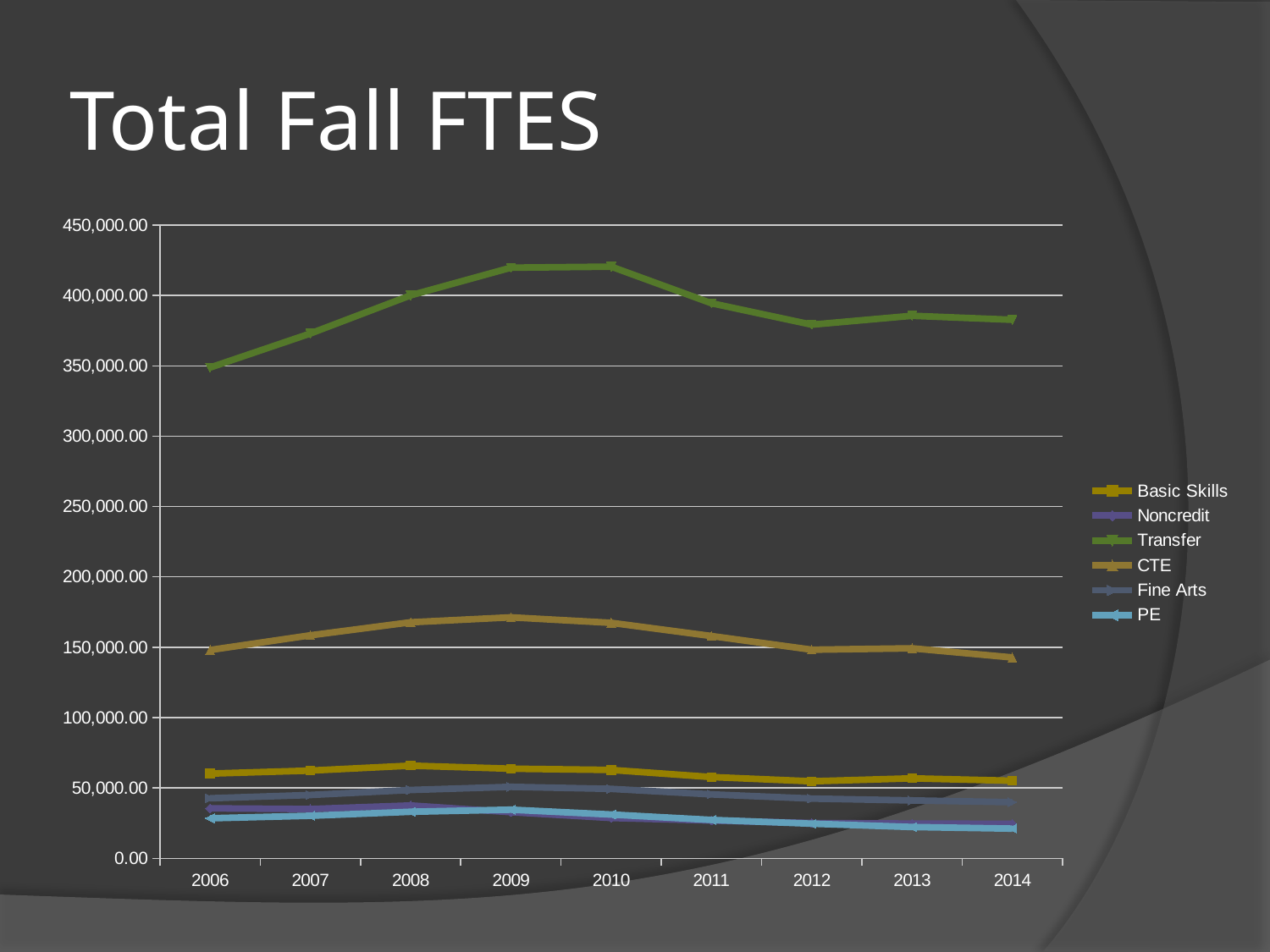
In which year is the value for Transfer lowest? 2006 What kind of chart is shown on the slide? Line chart In 2009, which is larger, the value for Transfer or the value for CTE? Transfer How many series does the legend list? 6 Is the value for Transfer in 2010 greater or less than 400,000.00? greater Is the value for CTE in 2009 greater or less than 150,000.00? greater Is the value for Transfer in 2012 greater or less than 400,000.00? less Do the values for Transfer rise or fall from 2006 to 2009? Rise Which series has the highest values across all years? Transfer What is the title of the chart? Total Fall FTES How many years are plotted along the x axis? 9